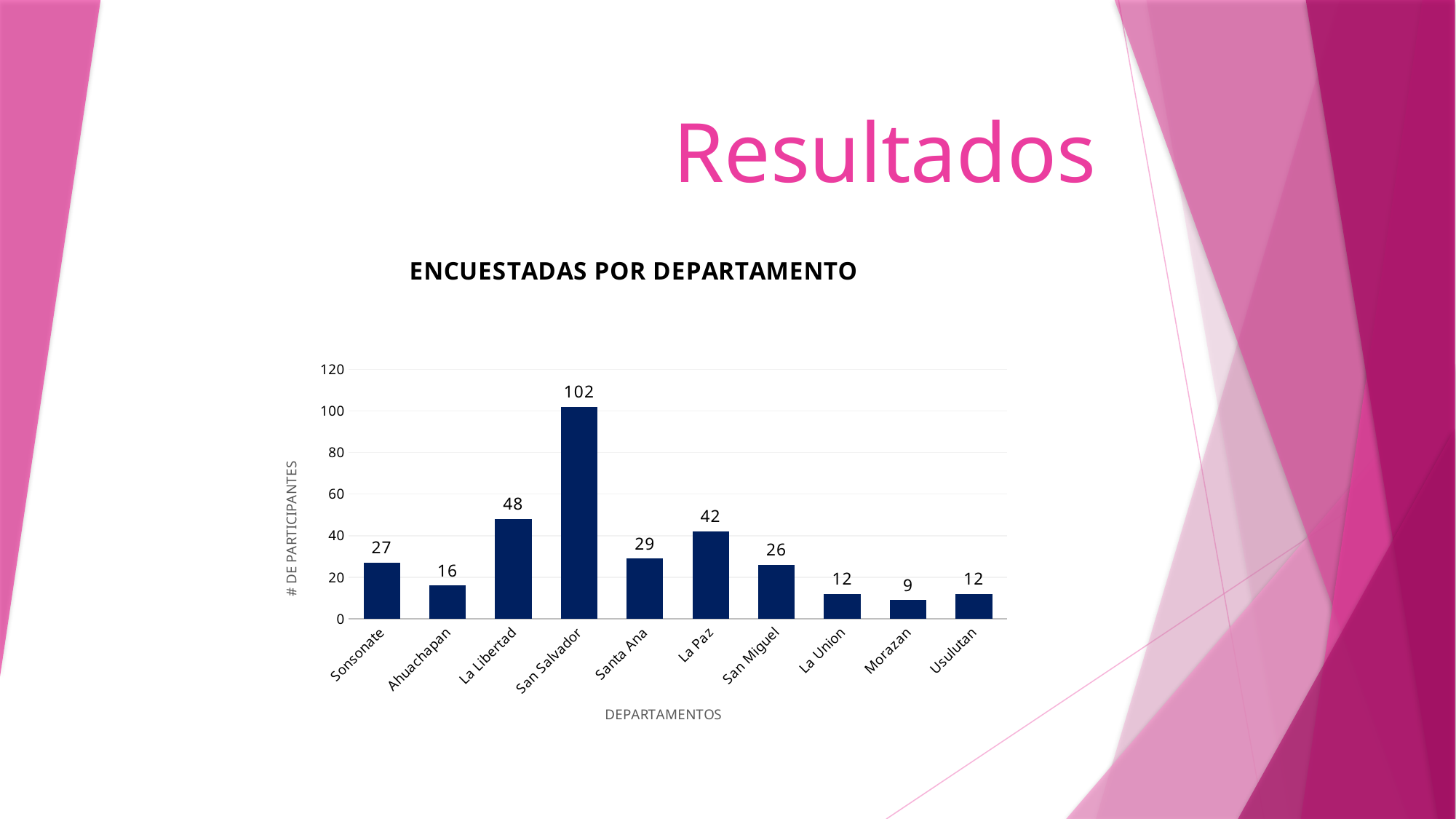
What is the value for San Salvador? 102 What is the title of the chart? ENCUESTADAS POR DEPARTAMENTO Is the value for San Salvador greater or less than 100? greater What is the difference between the values for La Paz and Santa Ana? 13 Which is larger, the value for Sonsonate or the value for Ahuachapan? Sonsonate Which department has the highest number of participants? San Salvador What is the value for La Libertad? 48 Which department has the lowest number of participants? Morazan What is the value for Morazan? 9 How many departments are shown on the x axis? 10 What is the difference between the values for San Salvador and La Libertad? 54 What kind of chart is shown on the slide? Bar chart